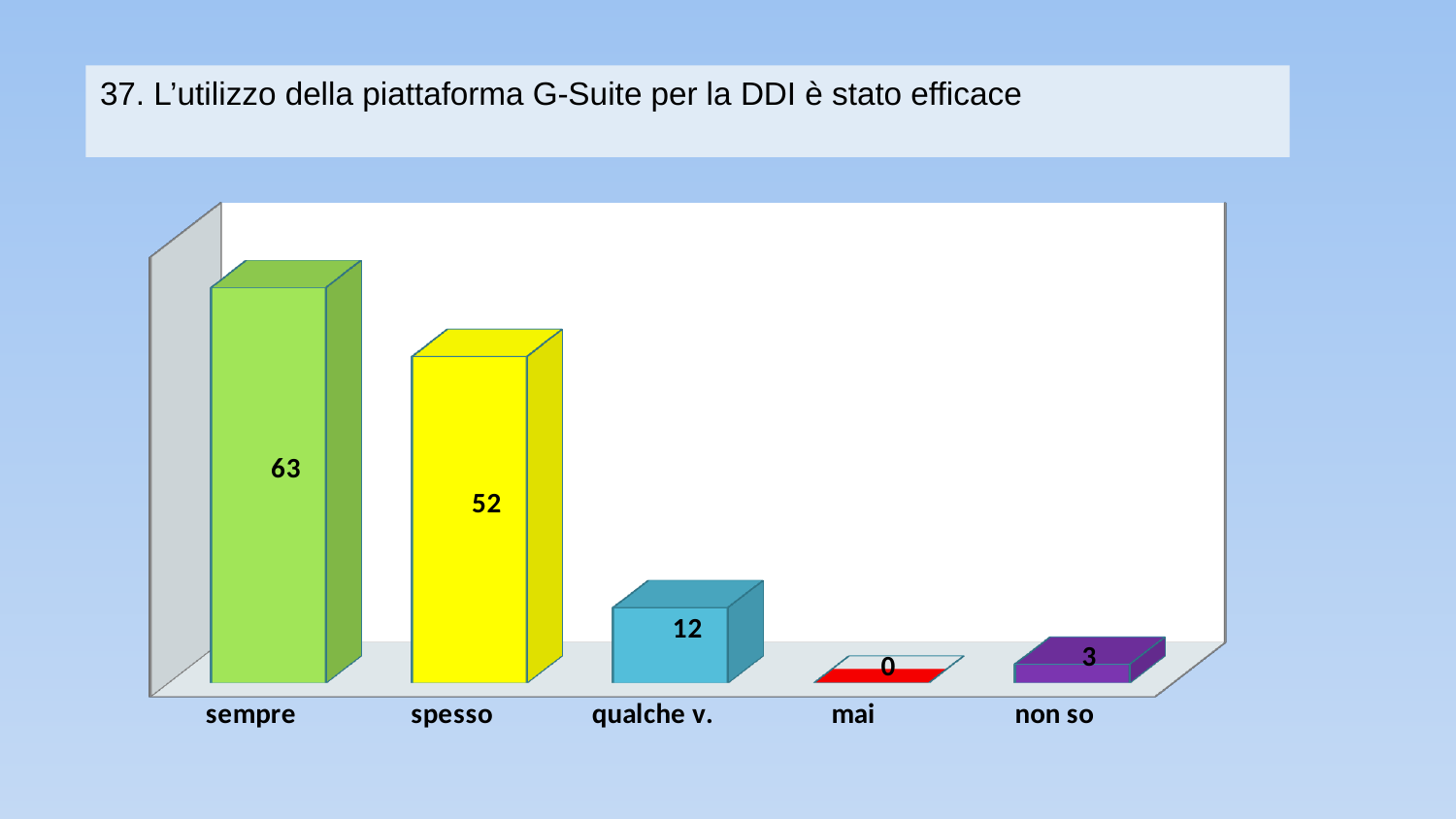
Which category has the highest value? sempre What is the value for "mai"? 0 What kind of chart is shown on the slide? bar chart How many categories are shown on the x axis? 5 What is the value for "spesso"? 52 What is the value for "non so"? 3 What is the difference between the values for "sempre" and "spesso"? 11 Which is larger, the value for "qualche v." or the value for "non so"? qualche v. What is the value for "qualche v."? 12 What is the title of the slide above the chart? 37. L'utilizzo della piattaforma G-Suite per la DDI è stato efficace Which category has the lowest value? mai What is the value for "sempre"? 63